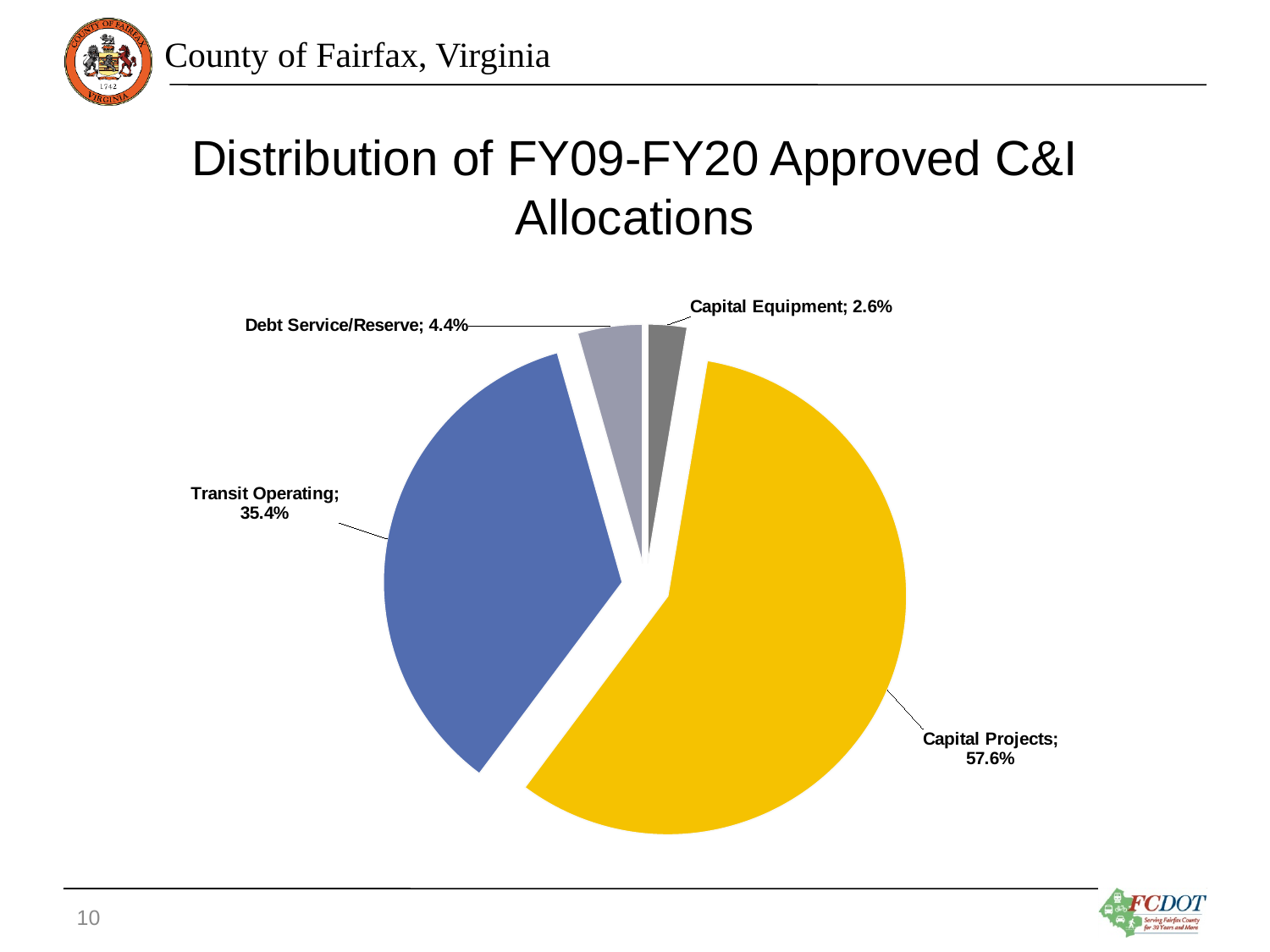
How many categories are shown in the pie chart? 4 Which category has the largest slice of the pie? Capital Projects What is the value shown for Debt Service/Reserve? 4.4% Which category has the smallest slice of the pie? Capital Equipment What share of the pie does Capital Projects represent? 57.6% What is the value shown for Capital Equipment? 2.6% What kind of chart is shown on the slide? Pie chart What colour is the Transit Operating slice? Blue What is the title of the chart on the slide? Distribution of FY09-FY20 Approved C&I Allocations Which is larger, Debt Service/Reserve or Capital Equipment? Debt Service/Reserve What is the value shown for Transit Operating? 35.4% What is the difference in percentage points between Capital Projects and Transit Operating? 22.2